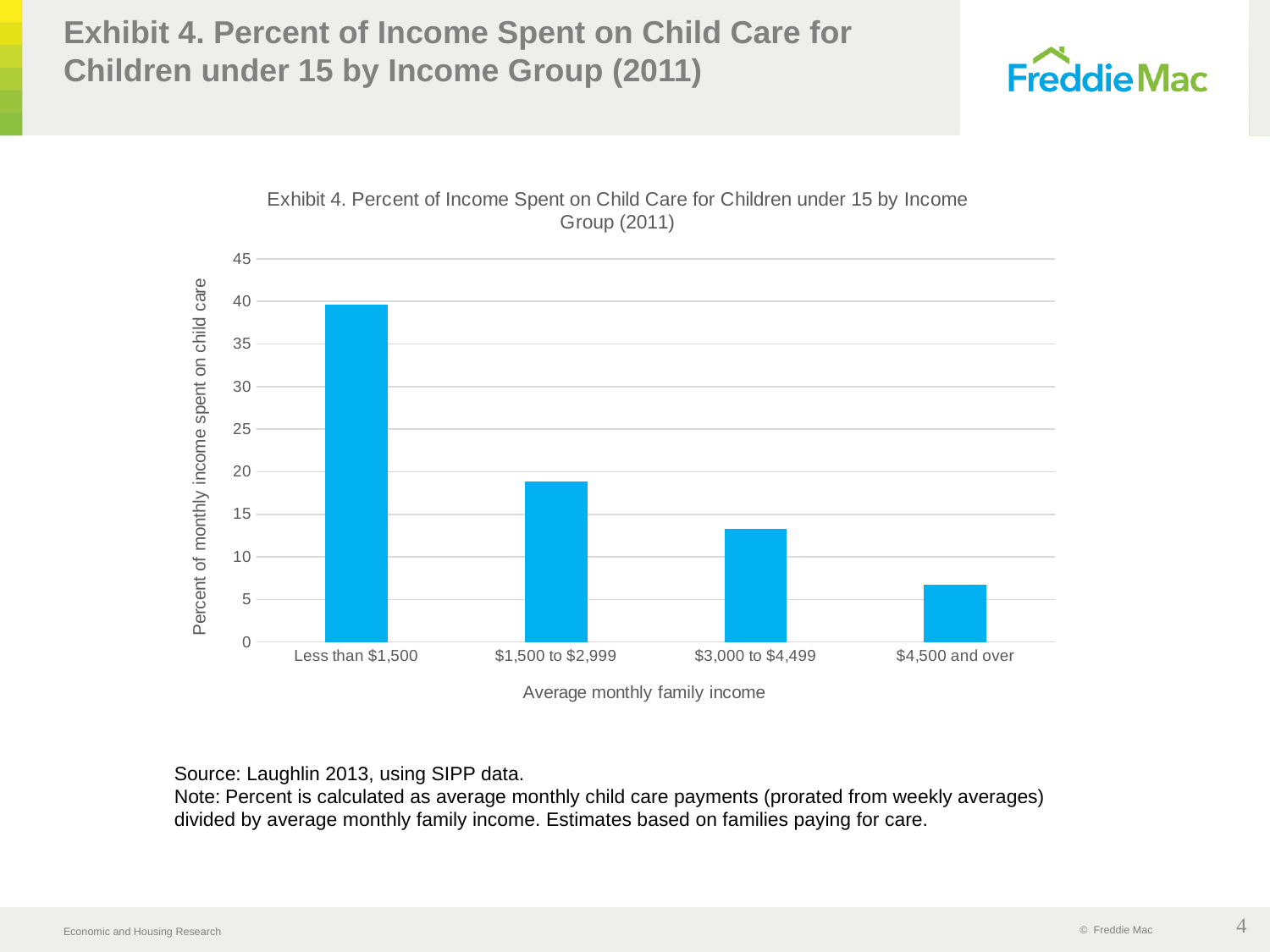
Which is larger, the value for $1,500 to $2,999 or the value for $3,000 to $4,499? $1,500 to $2,999 Which income group has the lowest percent of monthly income spent on child care? $4,500 and over Is the value for $4,500 and over greater or less than 10? less What kind of chart is shown on the slide? bar chart How many income groups are shown on the x axis? 4 Do the values rise or fall as average monthly family income increases along the x axis? fall Is the value for $1,500 to $2,999 greater or less than 20? less What is the label of the x axis? Average monthly family income What is the label of the y axis? Percent of monthly income spent on child care Is the value for Less than $1,500 greater or less than 35? greater Which income group has the highest percent of monthly income spent on child care? Less than $1,500